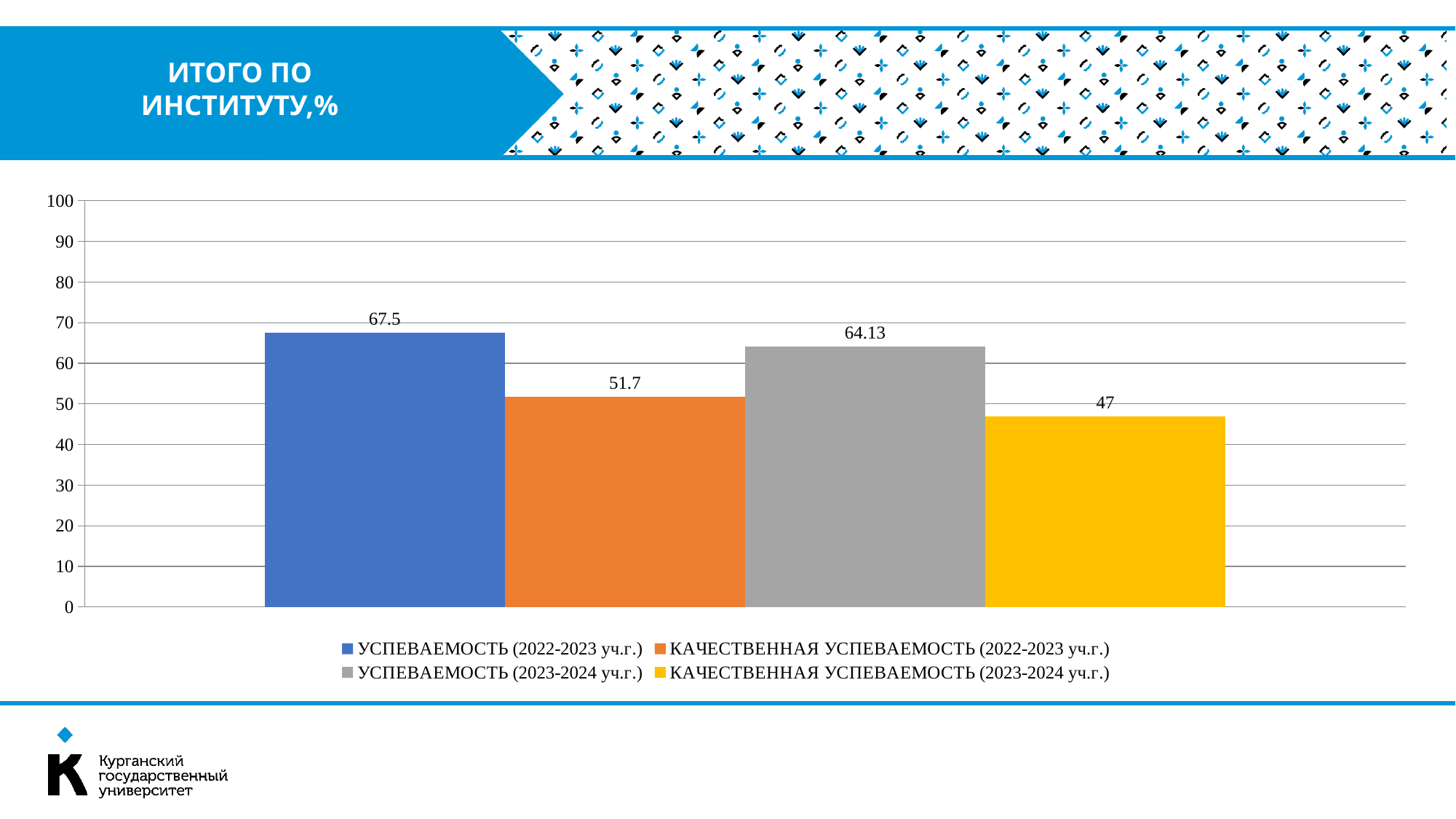
What is the value for КАЧЕСТВЕННАЯ УСПЕВАЕМОСТЬ (2023-2024 уч.г.)? 47 How many series does the legend list? 4 What is the value for КАЧЕСТВЕННАЯ УСПЕВАЕМОСТЬ (2022-2023 уч.г.)? 51.7 Which series has the lowest value? КАЧЕСТВЕННАЯ УСПЕВАЕМОСТЬ (2023-2024 уч.г.) What is the title of the slide? ИТОГО ПО ИНСТИТУТУ,% What is the difference between УСПЕВАЕМОСТЬ (2022-2023 уч.г.) and УСПЕВАЕМОСТЬ (2023-2024 уч.г.)? 3.37 What is the value for УСПЕВАЕМОСТЬ (2022-2023 уч.г.)? 67.5 Which is larger: КАЧЕСТВЕННАЯ УСПЕВАЕМОСТЬ (2022-2023 уч.г.) or КАЧЕСТВЕННАЯ УСПЕВАЕМОСТЬ (2023-2024 уч.г.)? КАЧЕСТВЕННАЯ УСПЕВАЕМОСТЬ (2022-2023 уч.г.) What is the value for УСПЕВАЕМОСТЬ (2023-2024 уч.г.)? 64.13 Which series has the highest value? УСПЕВАЕМОСТЬ (2022-2023 уч.г.) What is the difference between КАЧЕСТВЕННАЯ УСПЕВАЕМОСТЬ (2022-2023 уч.г.) and КАЧЕСТВЕННАЯ УСПЕВАЕМОСТЬ (2023-2024 уч.г.)? 4.7 What kind of chart is shown on the slide? Bar chart